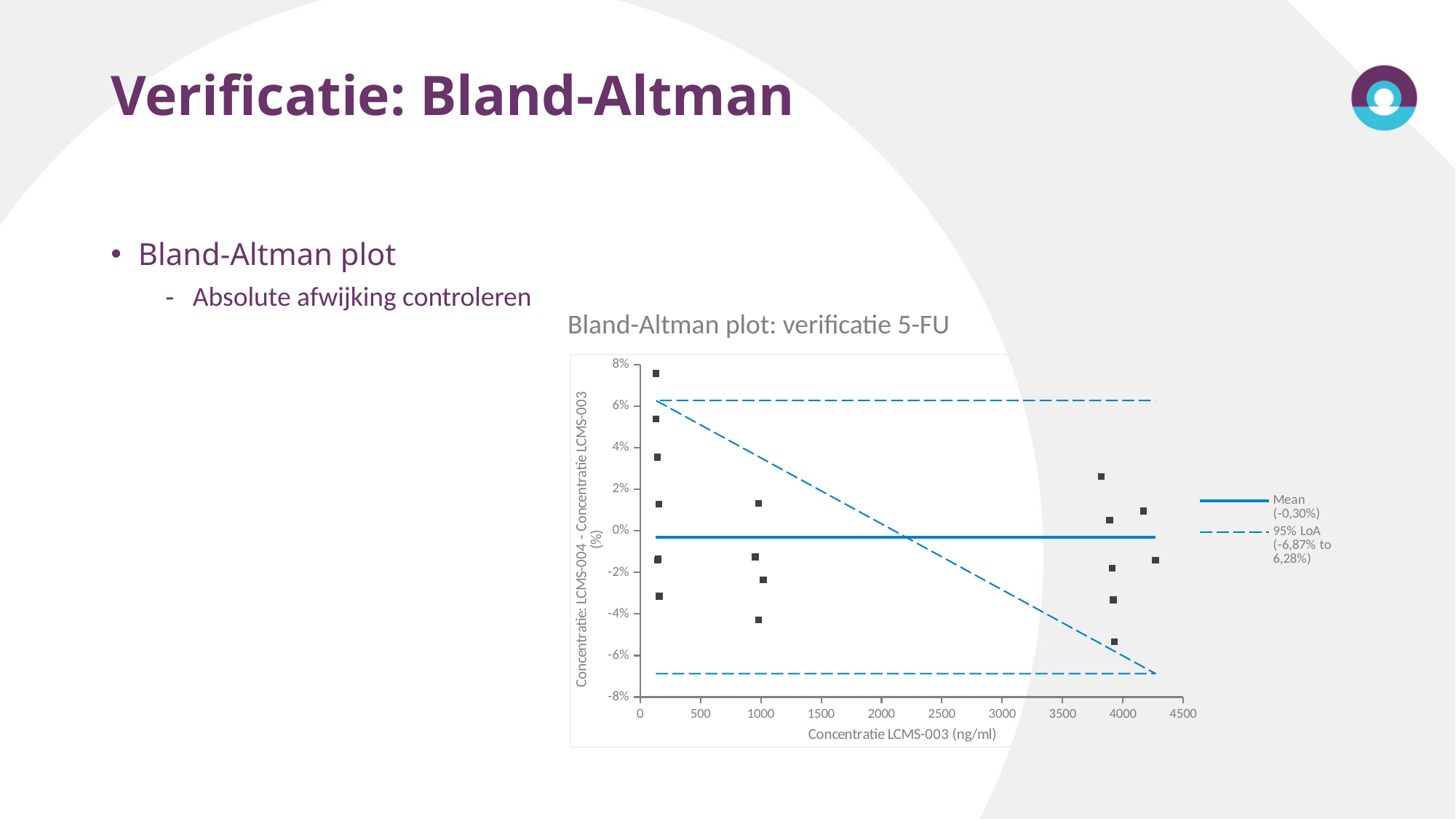
What is the highest value shown on the x axis of the chart? 4500 Is the mean line in the chart above or below 0%? below What is the label of the x axis of the chart? Concentratie LCMS-003 (ng/ml) Is the highest plotted point in the chart greater or less than 6%? greater Is the lowest plotted point in the chart greater or less than -4%? less What is the highest value shown on the y axis of the chart? 8% What is the title of the chart? Bland-Altman plot: verificatie 5-FU What are the 95% limits of agreement (LoA) given in the chart legend? -6,87% to 6,28% How many entries does the chart legend list? 2 What kind of chart is shown on the slide? scatter plot What mean value is given in the chart legend? -0,30%